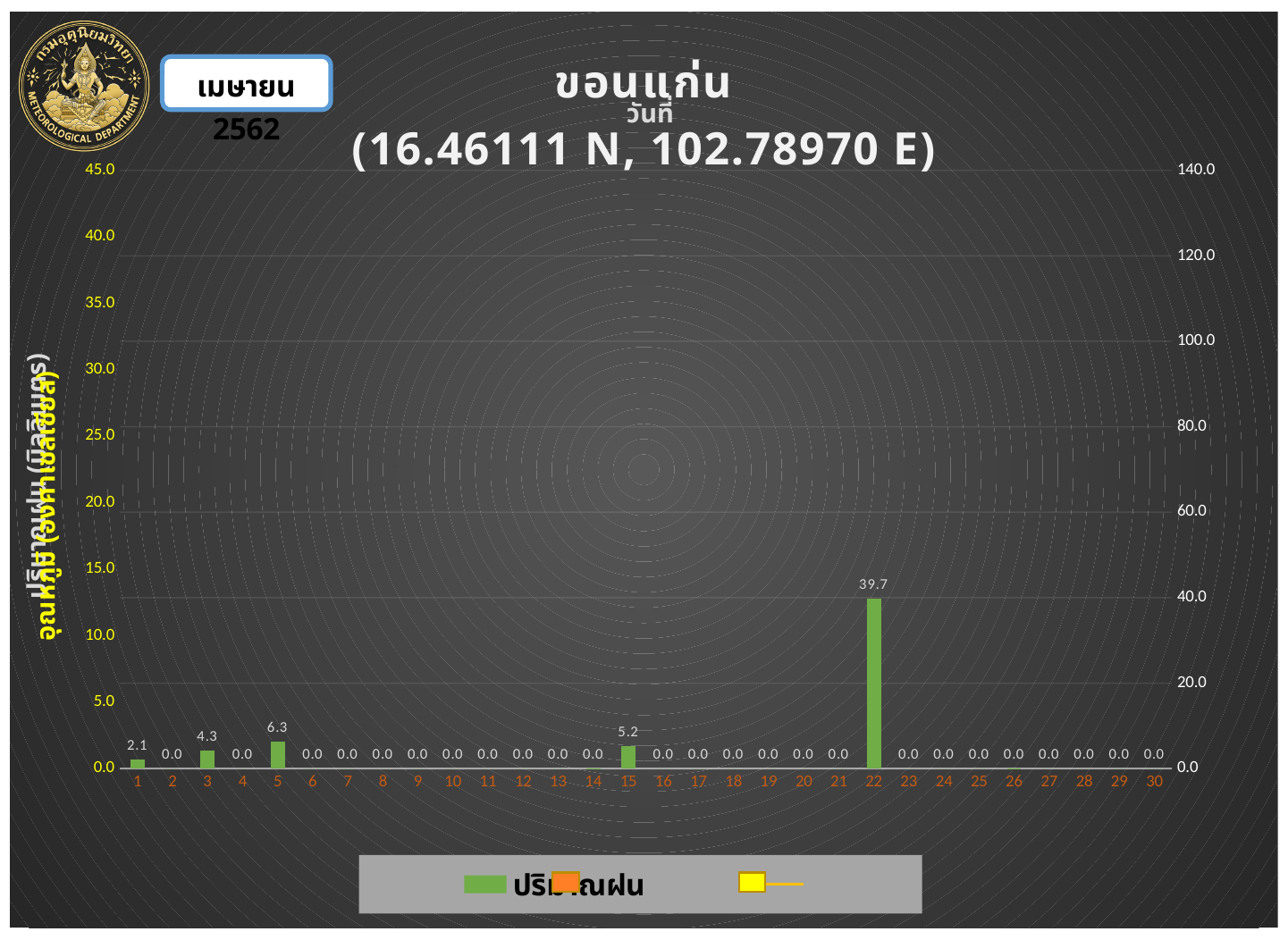
What is the rainfall value for day 15? 5.2 What location name is given in the chart title? ขอนแก่น What is the rainfall value for day 1? 2.1 Which has the larger rainfall value, day 3 or day 5? day 5 What is the rainfall value for day 5? 6.3 What is the difference between the rainfall values for day 22 and day 5? 33.4 What kind of chart is shown? bar chart What is the rainfall value for day 3? 4.3 Which day has the highest rainfall value? 22 What is the difference between the rainfall values for day 5 and day 3? 2.0 How many days are shown on the x axis? 30 What is the rainfall value for day 22? 39.7